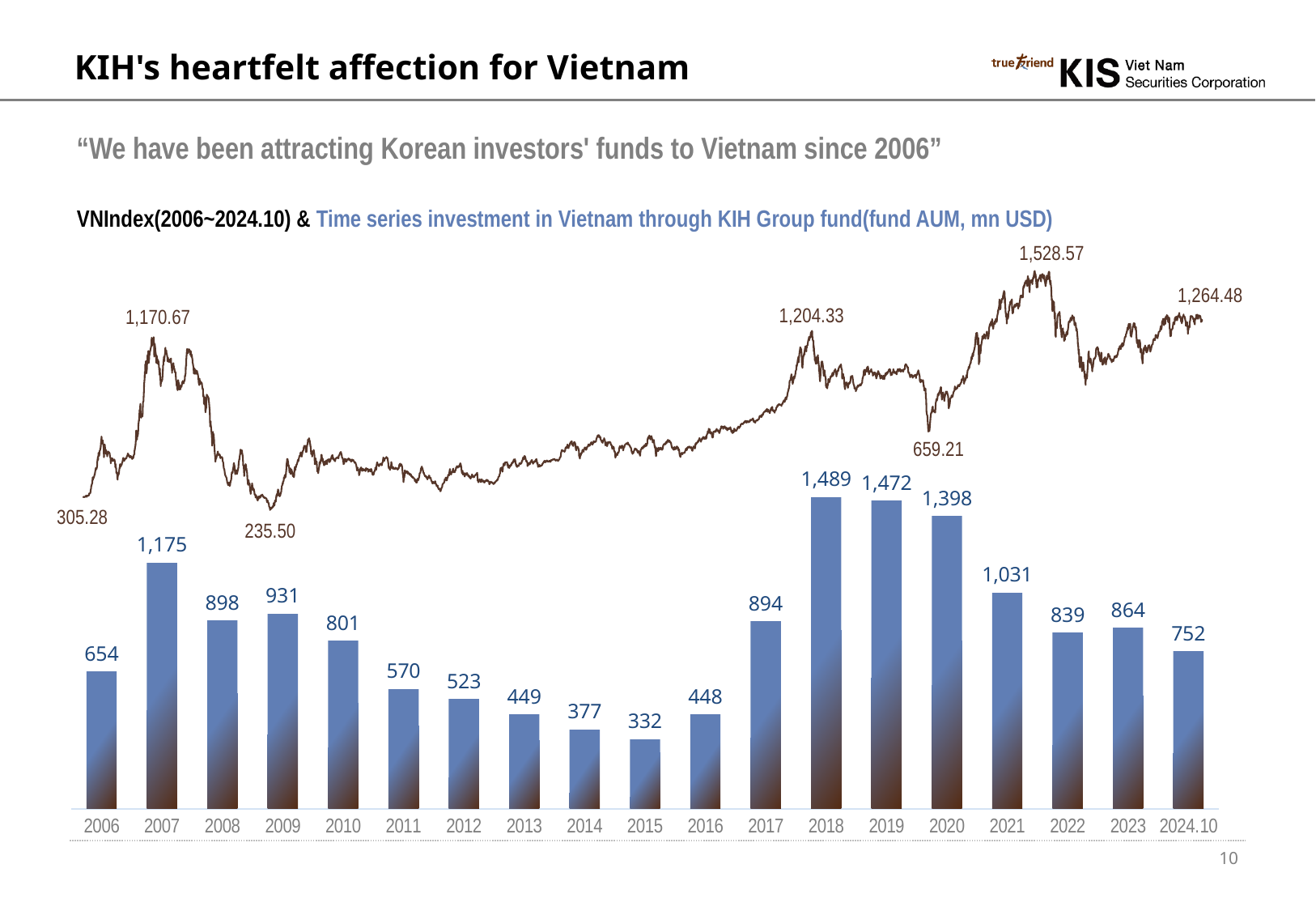
Which year has the highest fund AUM bar? 2018 Which year has the lowest fund AUM bar? 2015 How many years (bars) are shown on the x axis? 19 What is the highest VNIndex value labeled on the line? 1,528.57 What is the fund AUM value shown for 2018? 1,489 Which year has the larger fund AUM bar, 2022 or 2023? 2023 What is the difference between the fund AUM values for 2007 and 2006? 521 What is the fund AUM value shown for 2024.10? 752 What is the lowest VNIndex value labeled on the line? 235.50 What is the fund AUM value shown for 2015? 332 What is the difference between the fund AUM values for 2018 and 2019? 17 Do the fund AUM bars rise or fall from 2011 to 2015? fall